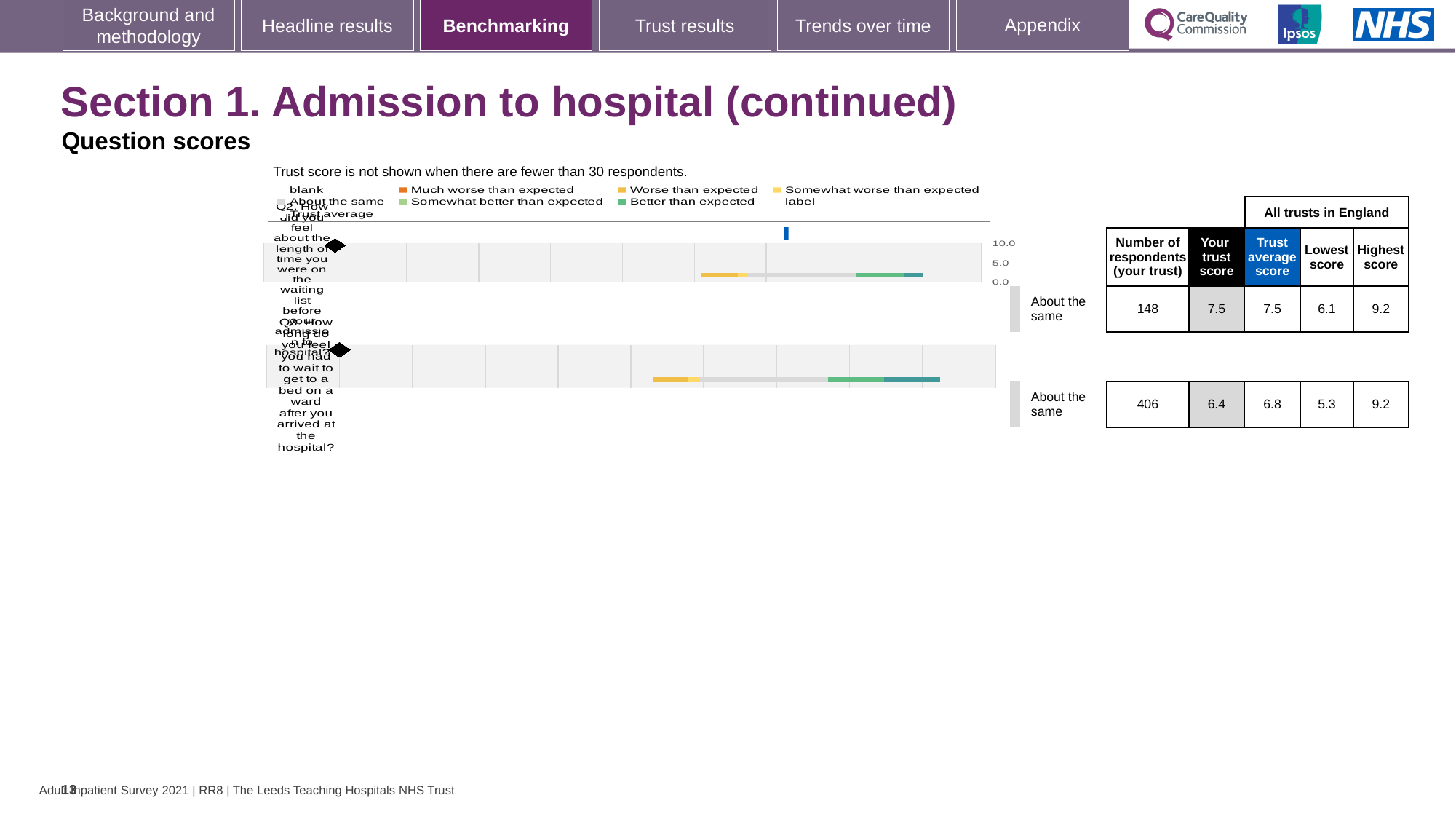
How many respondents answered Q3 at this trust? 406 What is the trust average score for Q3? 6.8 What is the trust score for Q2 (how did you feel about the length of time on the waiting list)? 7.5 What benchmark category is shown for Q2? About the same By how much is the trust average score for Q3 higher than this trust's score for Q3? 0.4 What is the highest score across all trusts in England for Q2? 9.2 How many respondents answered Q2 at this trust? 148 What is the trust score for Q3 (how long did you feel you had to wait to get to a bed on a ward)? 6.4 What is the lowest score across all trusts in England for Q3? 5.3 Which question has the higher trust score, Q2 or Q3? Q2 How many questions are plotted in the question scores chart? 2 What kind of chart is used to show the question scores on this slide? bar chart